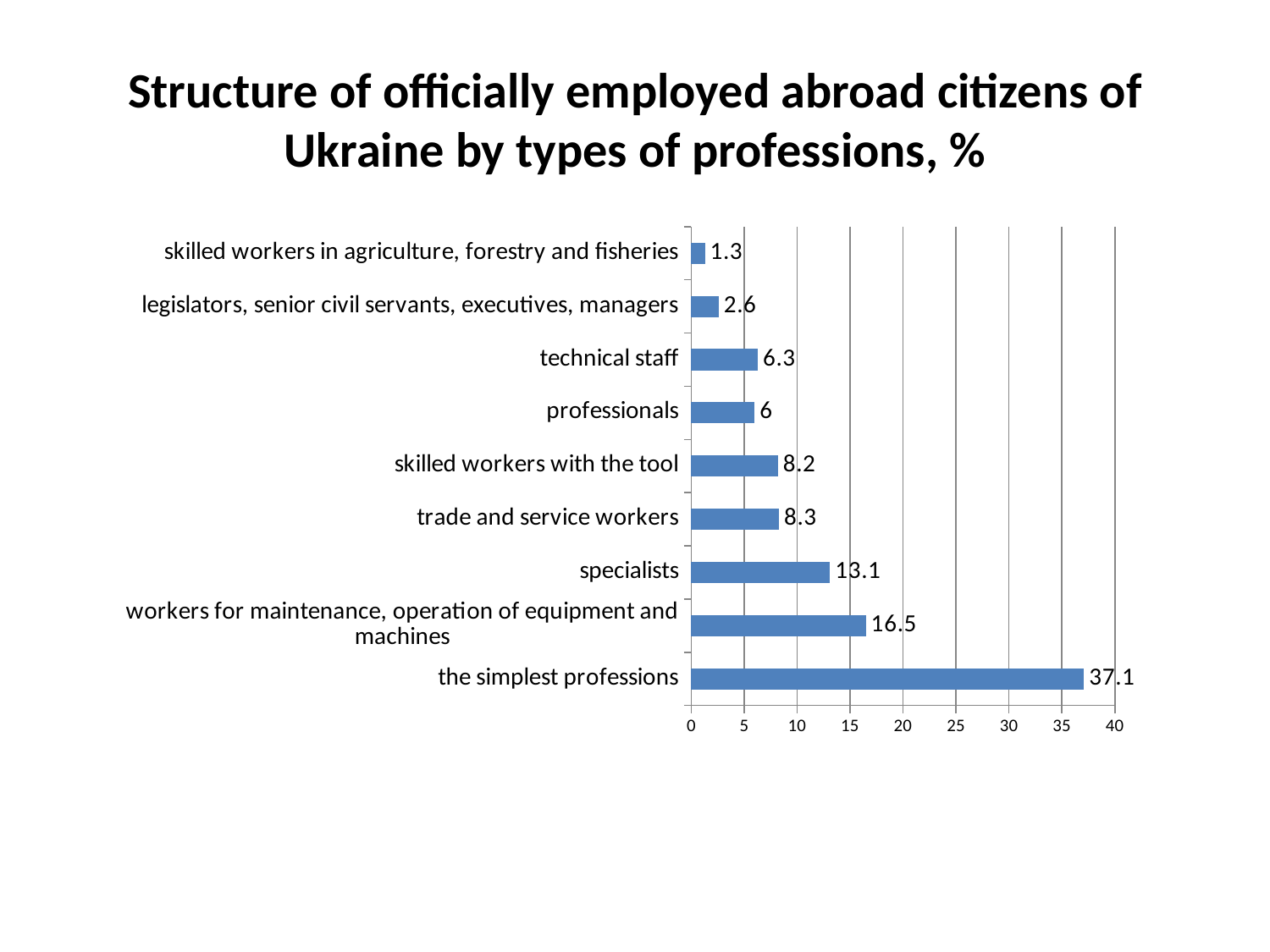
What kind of chart is shown on the slide? bar chart Which category has the lowest value? skilled workers in agriculture, forestry and fisheries What is the value for technical staff? 6.3 What is the difference between the values for technical staff and professionals? 0.3 Which is larger, the value for specialists or the value for trade and service workers? specialists How many categories are shown in the chart? 9 What is the value for specialists? 13.1 What is the difference between the values for the simplest professions and specialists? 24 What is the value for the simplest professions? 37.1 Which category has the highest value? the simplest professions What is the value for workers for maintenance, operation of equipment and machines? 16.5 Is the value for workers for maintenance, operation of equipment and machines greater or less than 15? greater